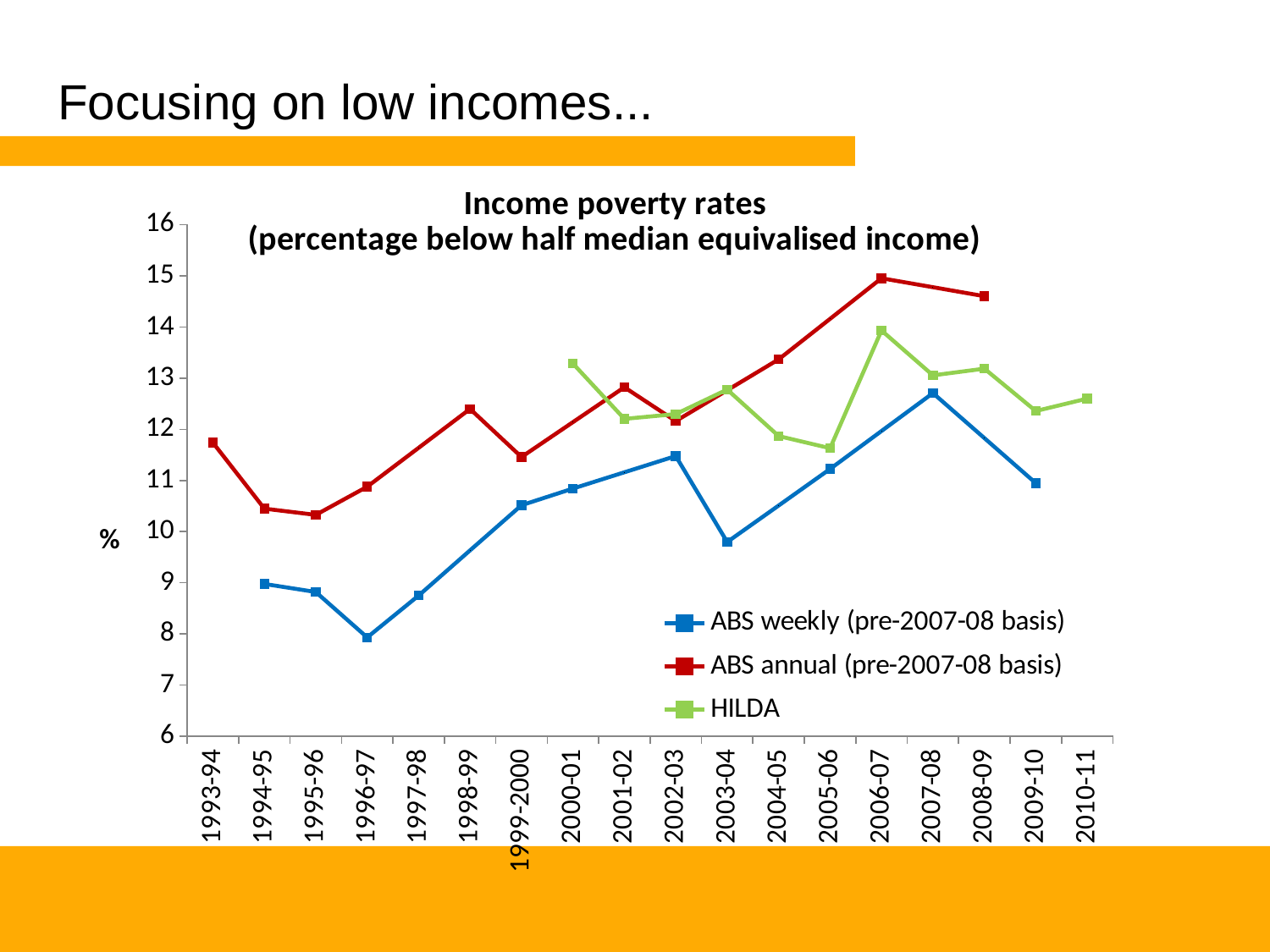
Is the value for HILDA in 2005-06 greater or less than 12? less Is the value for ABS annual (pre-2007-08 basis) in 2006-07 greater or less than 14? greater In 2000-01, which series has the higher value: HILDA or ABS weekly (pre-2007-08 basis)? HILDA What is the title of the chart? Income poverty rates (percentage below half median equivalised income) In which year does the ABS annual (pre-2007-08 basis) series reach its highest value? 2006-07 In which year does the HILDA series reach its highest value? 2006-07 What kind of chart is shown on the slide? Line chart What colour is the HILDA line? Green In which year does the ABS weekly (pre-2007-08 basis) series reach its lowest value? 1996-97 How many year categories are shown on the x axis? 18 How many series does the legend list? 3